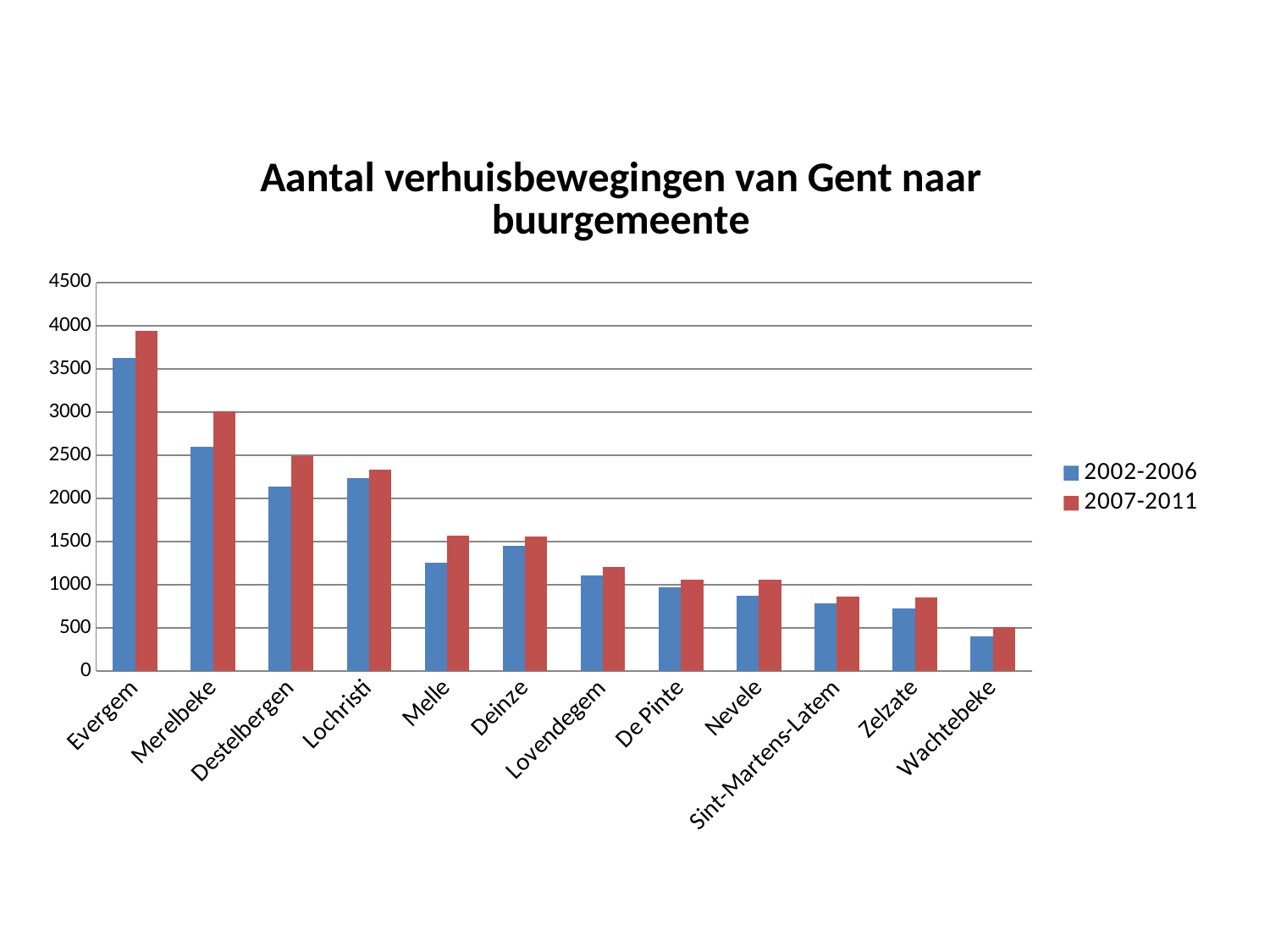
Which is larger for Merelbeke: the 2002-2006 value or the 2007-2011 value? 2007-2011 What is the title of the chart? Aantal verhuisbewegingen van Gent naar buurgemeente Is the value for Evergem in 2002-2006 greater or less than 3500? greater Which municipality has the lowest value for 2002-2006? Wachtebeke Is the value for Melle in 2002-2006 greater or less than 1000? greater How many municipalities are shown on the x axis? 12 Is the value for Wachtebeke in 2002-2006 greater or less than 500? less Which municipality has the larger 2002-2006 value: Evergem or Merelbeke? Evergem Which municipality has the highest value for 2007-2011? Evergem What type of chart is shown on the slide? bar chart How many series does the legend list? 2